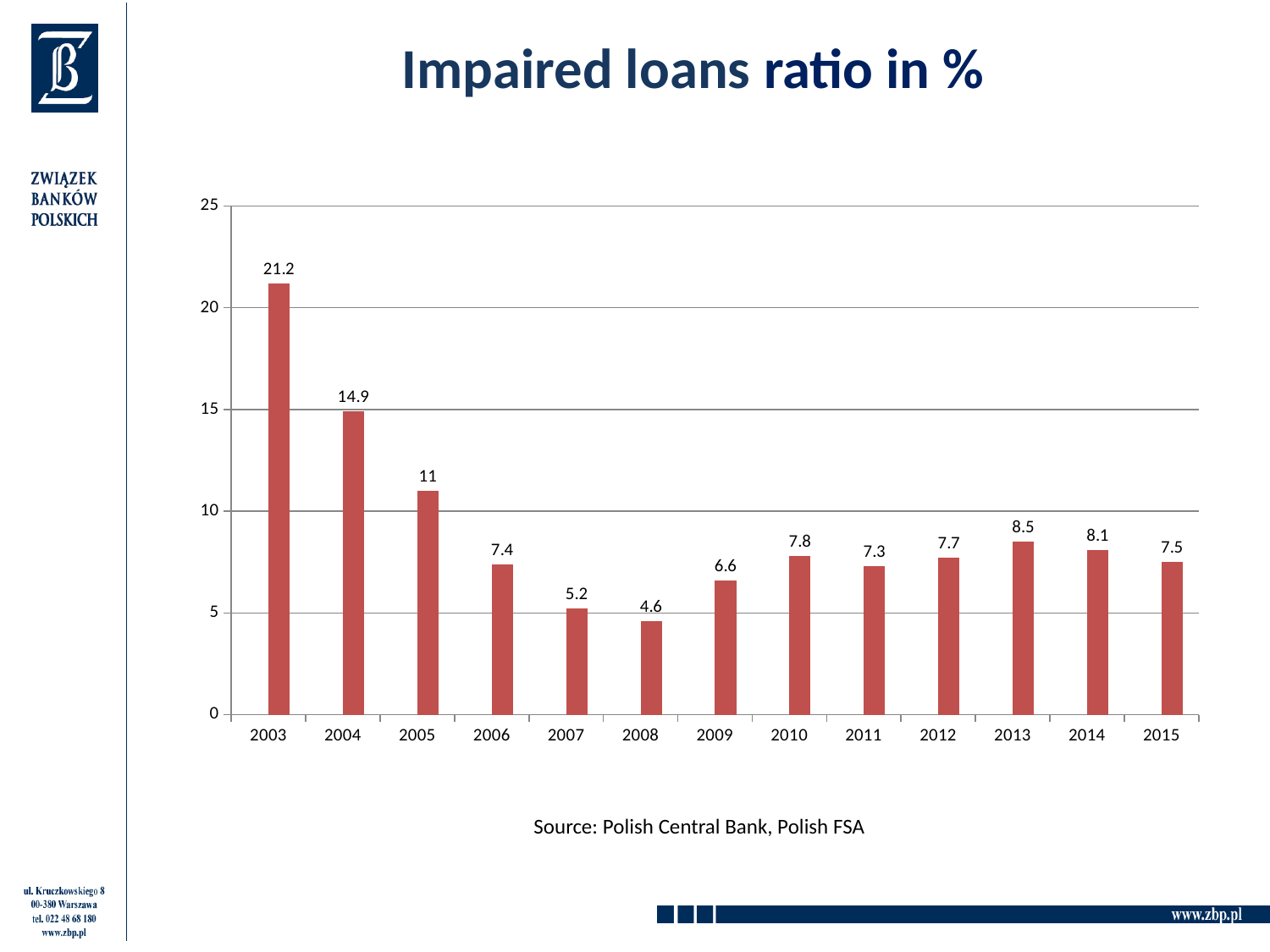
Which year has a higher impaired loans ratio, 2010 or 2011? 2010 Is the value for 2005 greater or less than 10? greater What kind of chart is shown on the slide? Bar chart What is the impaired loans ratio for 2003? 21.2 How many years are shown on the x axis? 13 What is the impaired loans ratio for 2013? 8.5 What is the impaired loans ratio for 2008? 4.6 What is the difference between the impaired loans ratio in 2003 and in 2004? 6.3 Which year has the highest impaired loans ratio? 2003 Which year has the lowest impaired loans ratio? 2008 What is the title of the chart? Impaired loans ratio in % What is the difference between the impaired loans ratio in 2014 and in 2015? 0.6